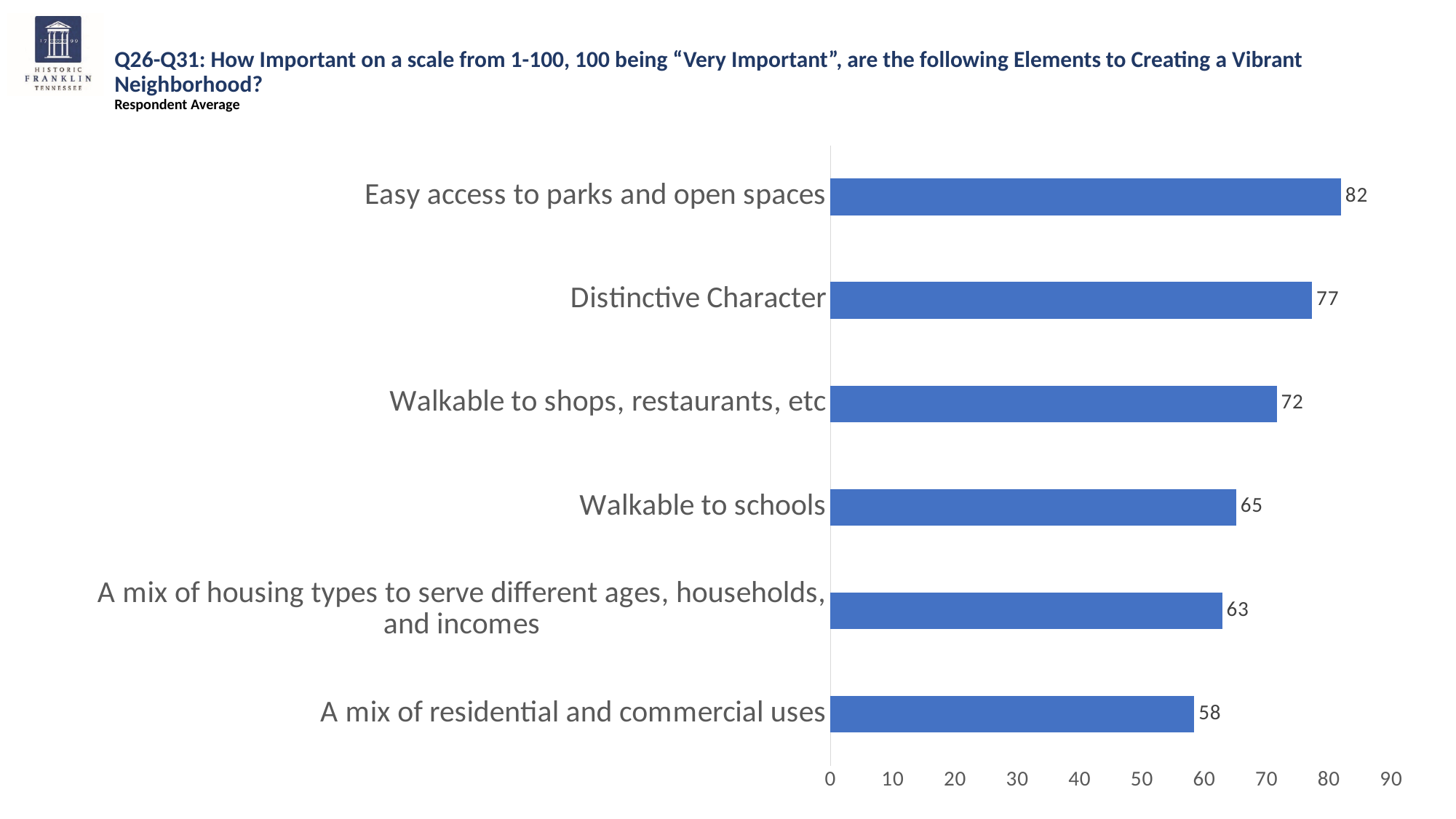
What kind of chart is shown on the slide? Bar chart What is the respondent average importance score for Easy access to parks and open spaces? 82 Is the value for Distinctive Character greater or less than 70? greater What is the maximum value shown on the horizontal axis? 90 What is the respondent average importance score for Walkable to schools? 65 What is the respondent average importance score for A mix of residential and commercial uses? 58 Which has a higher score: Walkable to schools or A mix of housing types to serve different ages, households, and incomes? Walkable to schools What is the difference between the scores for Distinctive Character and Walkable to shops, restaurants, etc? 5 What is the difference between the highest and lowest scores shown on the chart? 24 How many elements are shown on the chart? 6 Which element has the highest respondent average importance score? Easy access to parks and open spaces Which element has the lowest respondent average importance score? A mix of residential and commercial uses